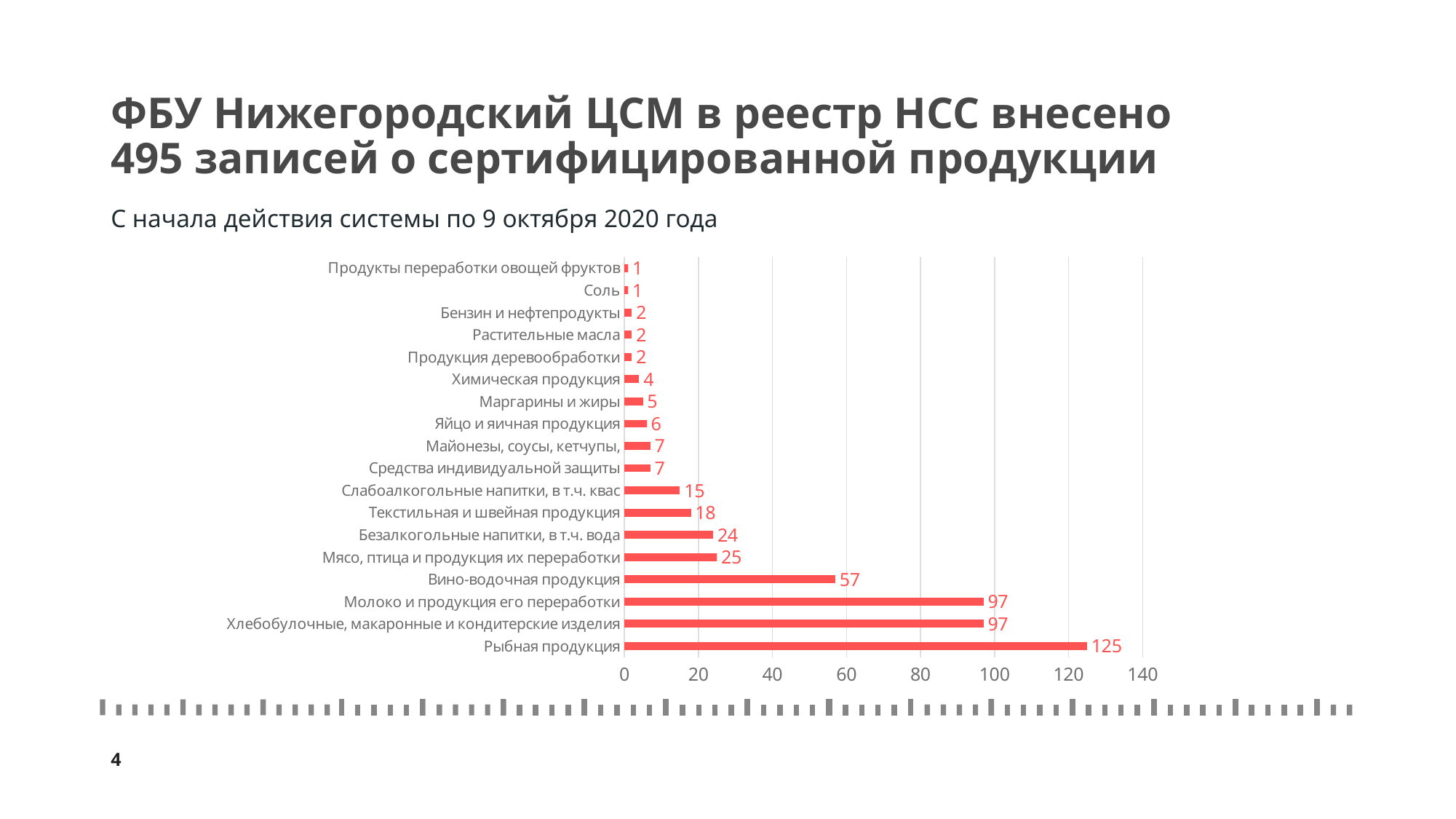
What kind of chart is shown on the slide? bar chart How many categories are shown in the chart? 18 Which is larger, the value for Вино-водочная продукция or the value for Слабоалкогольные напитки, в т.ч. квас? Вино-водочная продукция What is the difference between the values for Рыбная продукция and Молоко и продукция его переработки? 28 Which category has the highest value? Рыбная продукция What is the value for Рыбная продукция? 125 Is the value for Рыбная продукция greater or less than 100? greater What is the value for Текстильная и швейная продукция? 18 What is the value for Маргарины и жиры? 5 What is the highest value shown on the horizontal axis? 140 What is the difference between the values for Мясо, птица и продукция их переработки and Безалкогольные напитки, в т.ч. вода? 1 What is the value for Вино-водочная продукция? 57